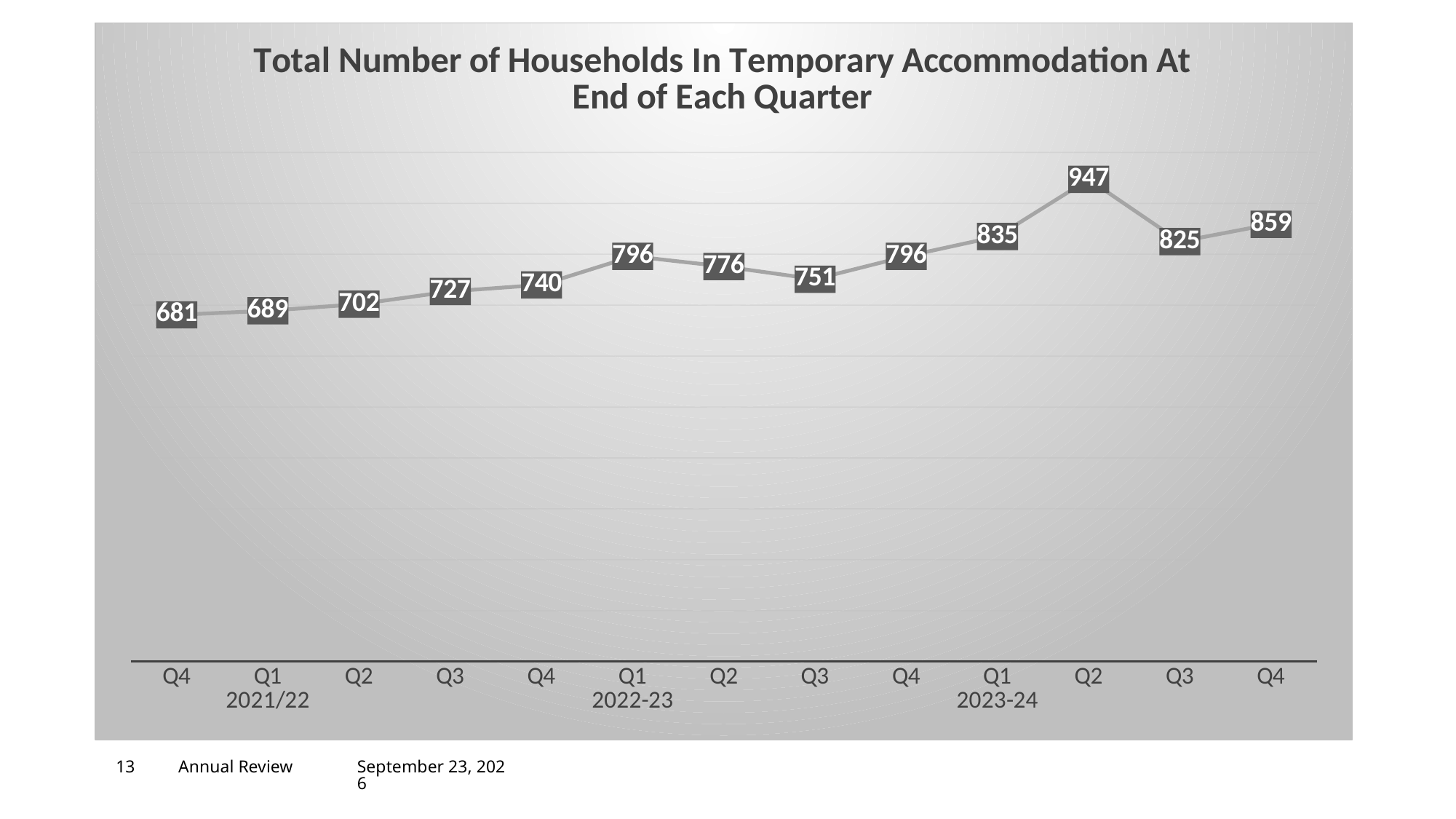
Which is larger, the value for Q1 2022-23 or Q2 2022-23? Q1 2022-23 How many data points are plotted on the chart? 13 What is the value for Q4 of 2021/22? 740 What is the value for Q2 of 2023-24? 947 What is the difference between the values for Q2 2023-24 and Q3 2023-24? 122 What kind of chart is shown on the slide? Line chart What is the difference between the values for Q4 2023-24 and Q1 2021/22? 170 What is the lowest value shown on the chart? 681 Which quarter has the highest number of households in temporary accommodation? Q2 2023-24 What is the value for the leftmost point (Q4) on the chart? 681 Overall, do the values rise or fall from the first quarter to the last quarter shown? Rise What is the value for Q3 of 2022-23? 751